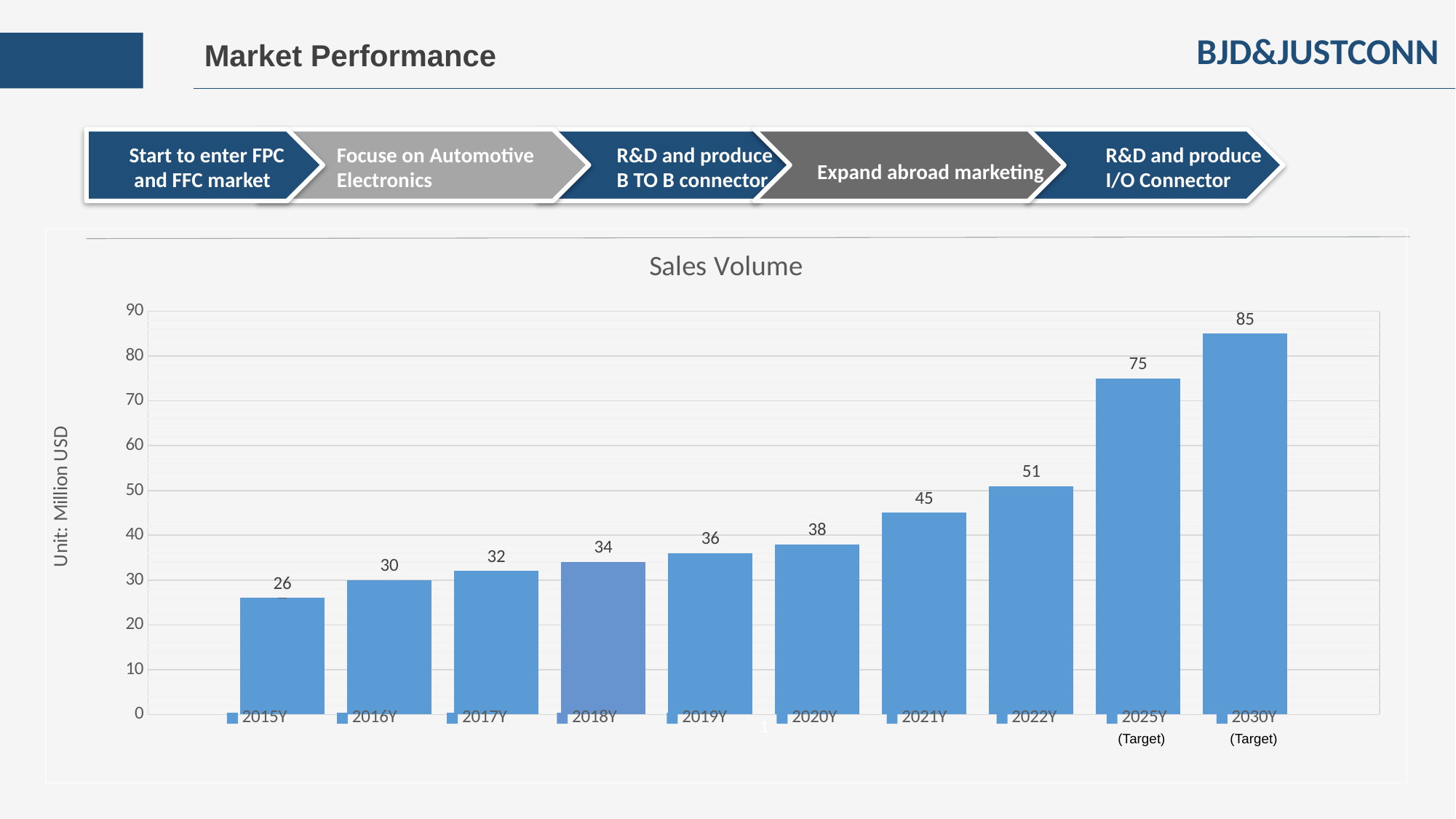
What is the difference in sales volume between the 2030Y target and the 2025Y target? 10 Which is larger, the sales volume for 2017Y or for 2019Y? 2019Y What is the sales volume for 2015Y? 26 Which year has the lowest sales volume? 2015Y What is the sales volume target for 2030Y? 85 How many years are shown on the x axis of the chart? 10 What kind of chart is shown on the slide? Bar chart What is the difference in sales volume between 2022Y and 2021Y? 6 What is the sales volume for 2020Y? 38 What is the title of the chart? Sales Volume Which year has the highest sales volume? 2030Y Do the sales volume values rise or fall from 2015Y to 2030Y? Rise